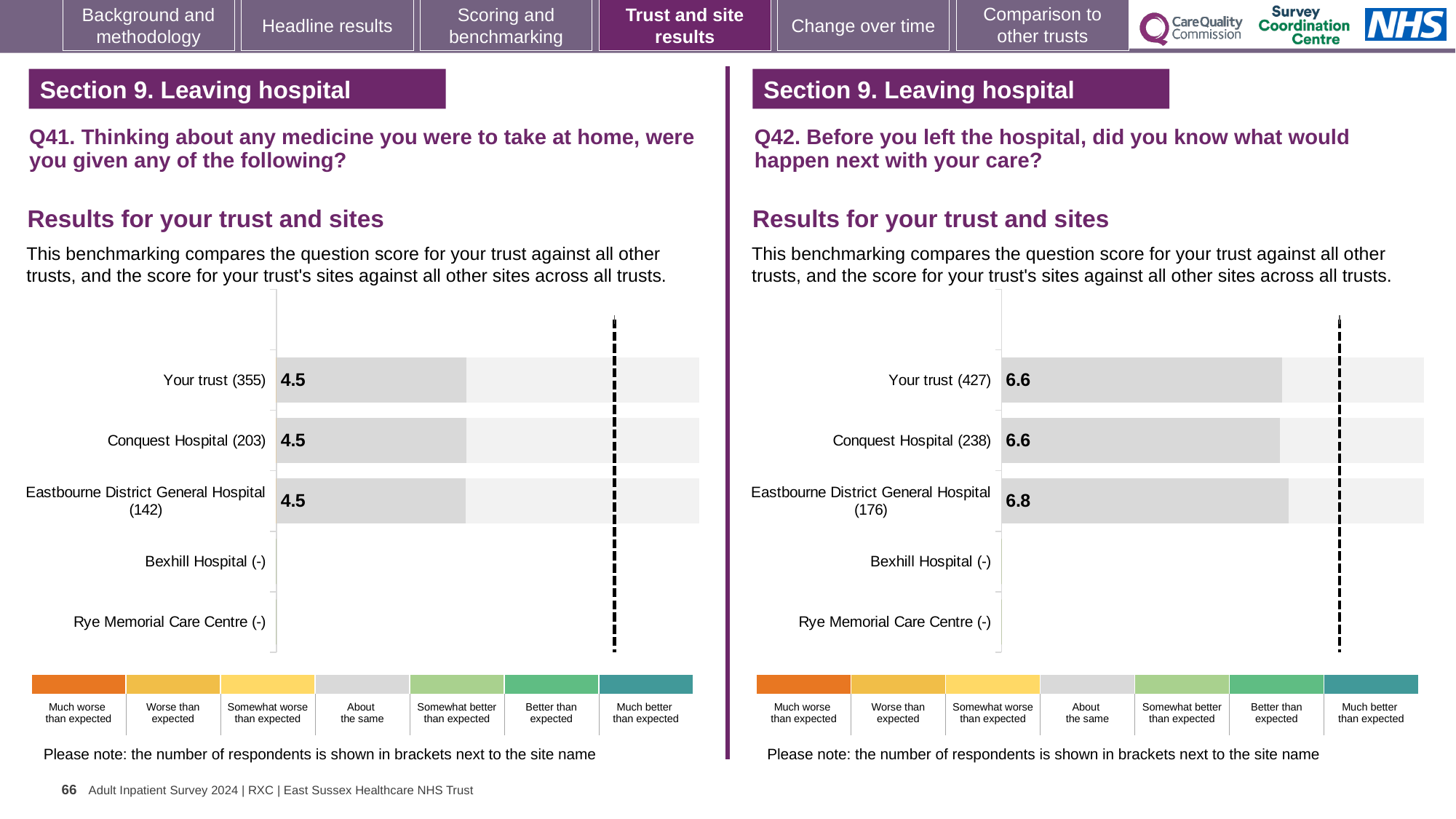
In the Q41 chart on the left, what is the score for Eastbourne District General Hospital (142)? 4.5 In the Q41 chart on the left, how many rows have a plotted bar with a score? 3 In the Q41 chart on the left, what is the score for Your trust (355)? 4.5 In the Q42 chart on the right, what is the difference between the scores for Eastbourne District General Hospital (176) and Your trust (427)? 0.2 In the Q41 chart on the left, how many site rows are listed on the vertical axis? 5 In the Q42 chart on the right, what is the score for Conquest Hospital (238)? 6.6 In the Q42 chart on the right, what is the score for Your trust (427)? 6.6 In the Q42 chart on the right, is the score for Eastbourne District General Hospital (176) larger than the score for Conquest Hospital (238)? Yes What kind of chart is the Q42 chart on the right? Bar chart In the Q41 chart on the left, how many respondents are shown for Conquest Hospital? 203 In the Q42 chart on the right, what is the score for Eastbourne District General Hospital (176)? 6.8 In the Q42 chart on the right, which site has the highest score? Eastbourne District General Hospital (176)